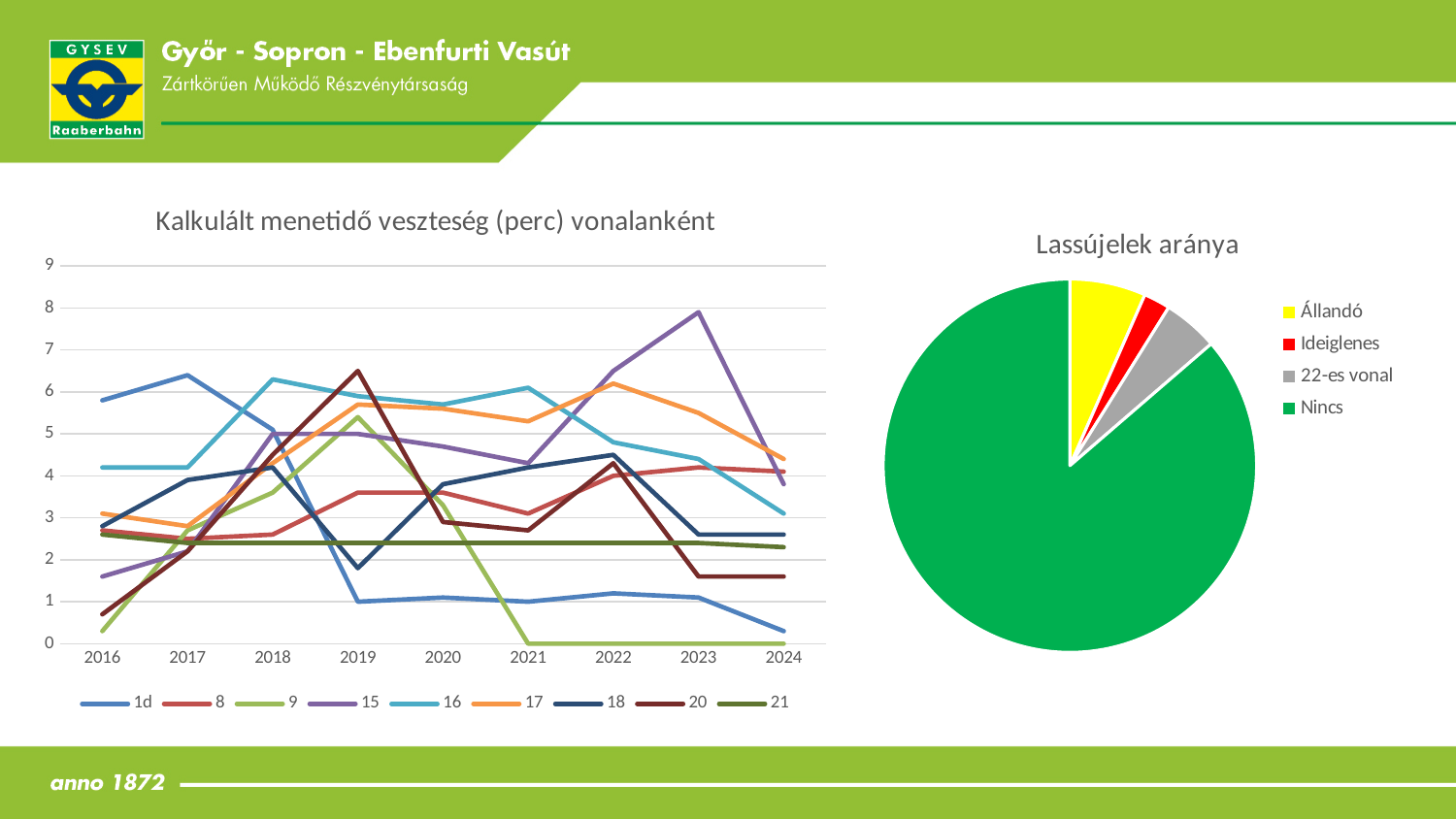
In the chart "Kalkulált menetidő veszteség (perc) vonalanként", how many years are shown on the x axis? 9 In the chart "Kalkulált menetidő veszteség (perc) vonalanként", how many series does the legend list? 9 What kind of chart is the chart titled "Kalkulált menetidő veszteség (perc) vonalanként"? line chart In the chart "Kalkulált menetidő veszteség (perc) vonalanként", which is larger in 2016: the value for series 1d or the value for series 20? 1d In the chart "Kalkulált menetidő veszteség (perc) vonalanként", which series has the highest value in 2023? 15 In the chart "Kalkulált menetidő veszteség (perc) vonalanként", is the value for series 15 in 2023 greater or less than 7? greater In the chart "Lassújelek aránya", which category has the largest slice? Nincs In the chart "Kalkulált menetidő veszteség (perc) vonalanként", is the value for series 1d in 2019 greater or less than 2? less What kind of chart is the chart titled "Lassújelek aránya"? pie chart In the chart "Kalkulált menetidő veszteség (perc) vonalanként", what is the value for series 9 in 2024? 0 In the chart "Lassújelek aránya", how many slices does the pie have? 4 In the chart "Kalkulált menetidő veszteség (perc) vonalanként", does the value for series 1d rise or fall from 2016 to 2024? fall